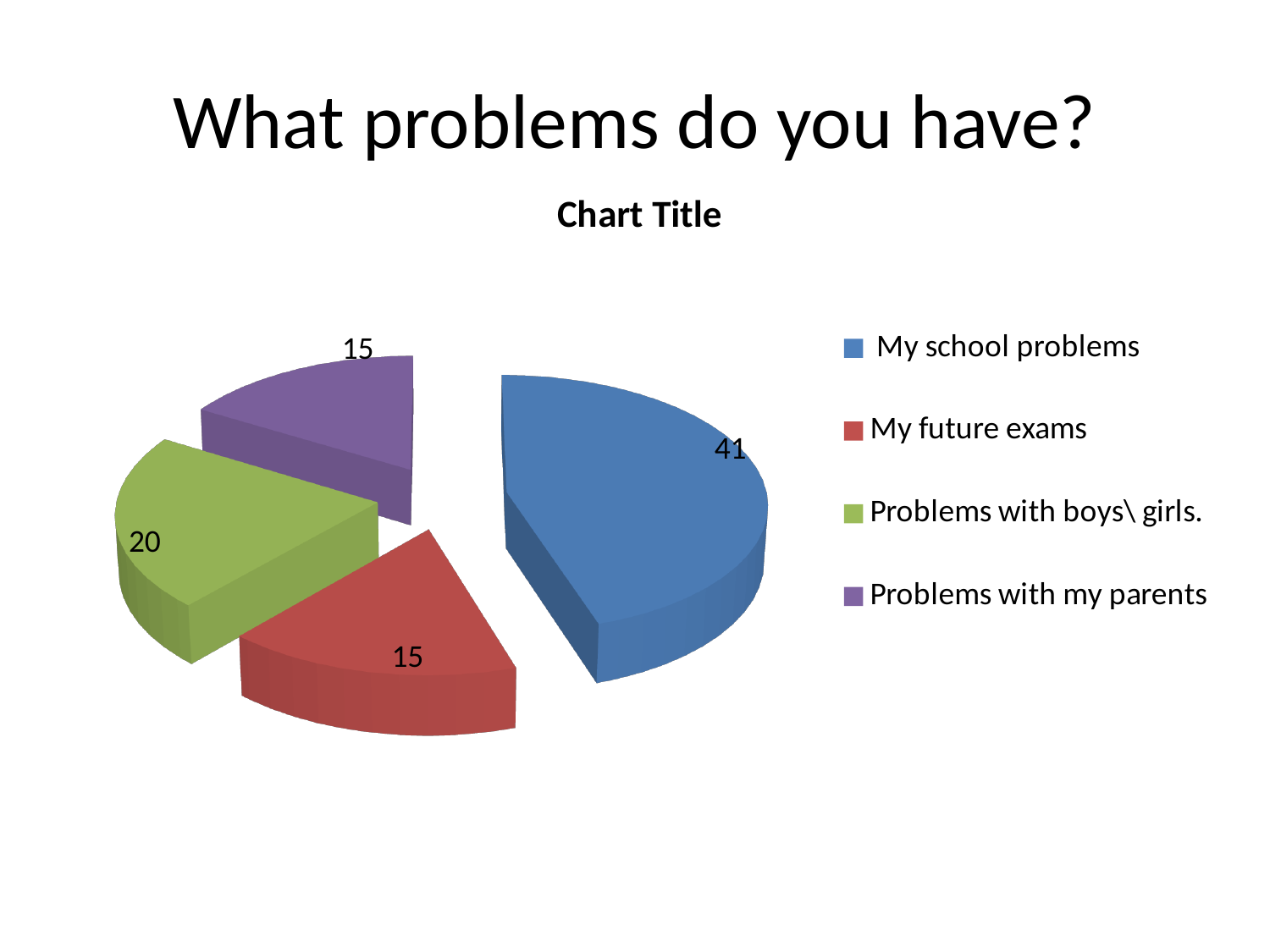
What is the difference between the values for Problems with boys\ girls. and My future exams? 5 What is the difference between the values for My school problems and Problems with boys\ girls.? 21 What value is shown for Problems with boys\ girls.? 20 What kind of chart is shown on the slide? Pie chart Which category has the largest slice of the pie? My school problems What value is shown for Problems with my parents? 15 What value is shown for My future exams? 15 Which is larger, the value for My school problems or the value for Problems with boys\ girls.? My school problems How many slices does the pie chart have? 4 What is the total of all the values shown in the pie chart? 91 What value is shown for My school problems? 41 What colour is the slice for My future exams? Red